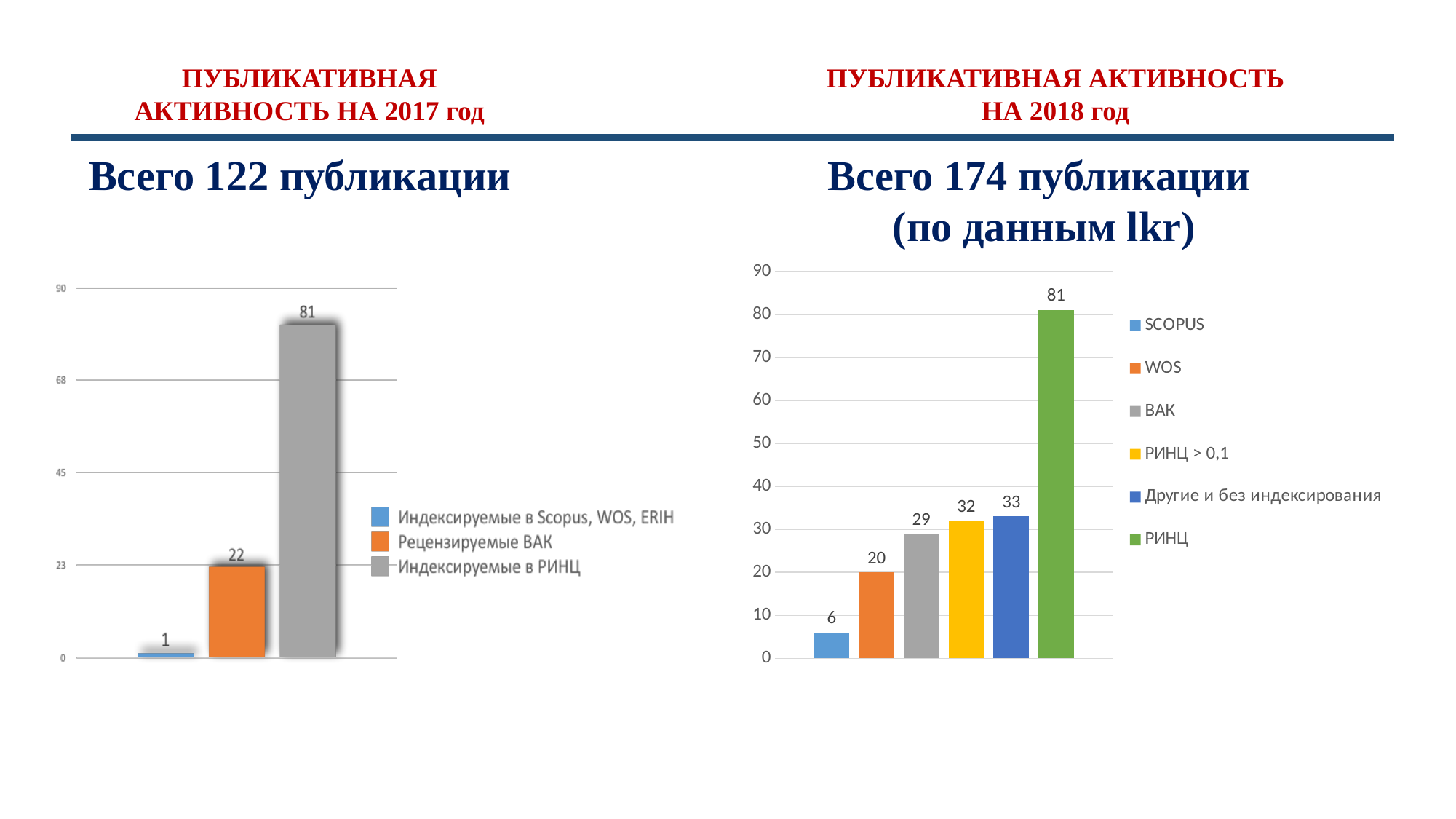
In the 2017 chart (left), which category has the lowest value? Индексируемые в Scopus, WOS, ERIH In the 2017 chart (left), what is the value for Индексируемые в РИНЦ? 81 In the 2017 chart (left), what is the difference between Индексируемые в РИНЦ and Рецензируемые ВАК? 59 In the 2018 chart (right), what is the difference between Другие и без индексирования and SCOPUS? 27 In the 2017 chart (left), what is the value for Рецензируемые ВАК? 22 In the 2018 chart (right), what is the value for РИНЦ > 0,1? 32 In the 2018 chart (right), which is larger, ВАК or SCOPUS? ВАК What type of chart is the 2018 chart (right)? Bar chart In the 2018 chart (right), which category has the highest value? РИНЦ In the 2018 chart (right), how many bars are plotted? 6 In the 2017 chart (left), how many series does the legend list? 3 In the 2018 chart (right), what is the value for WOS? 20